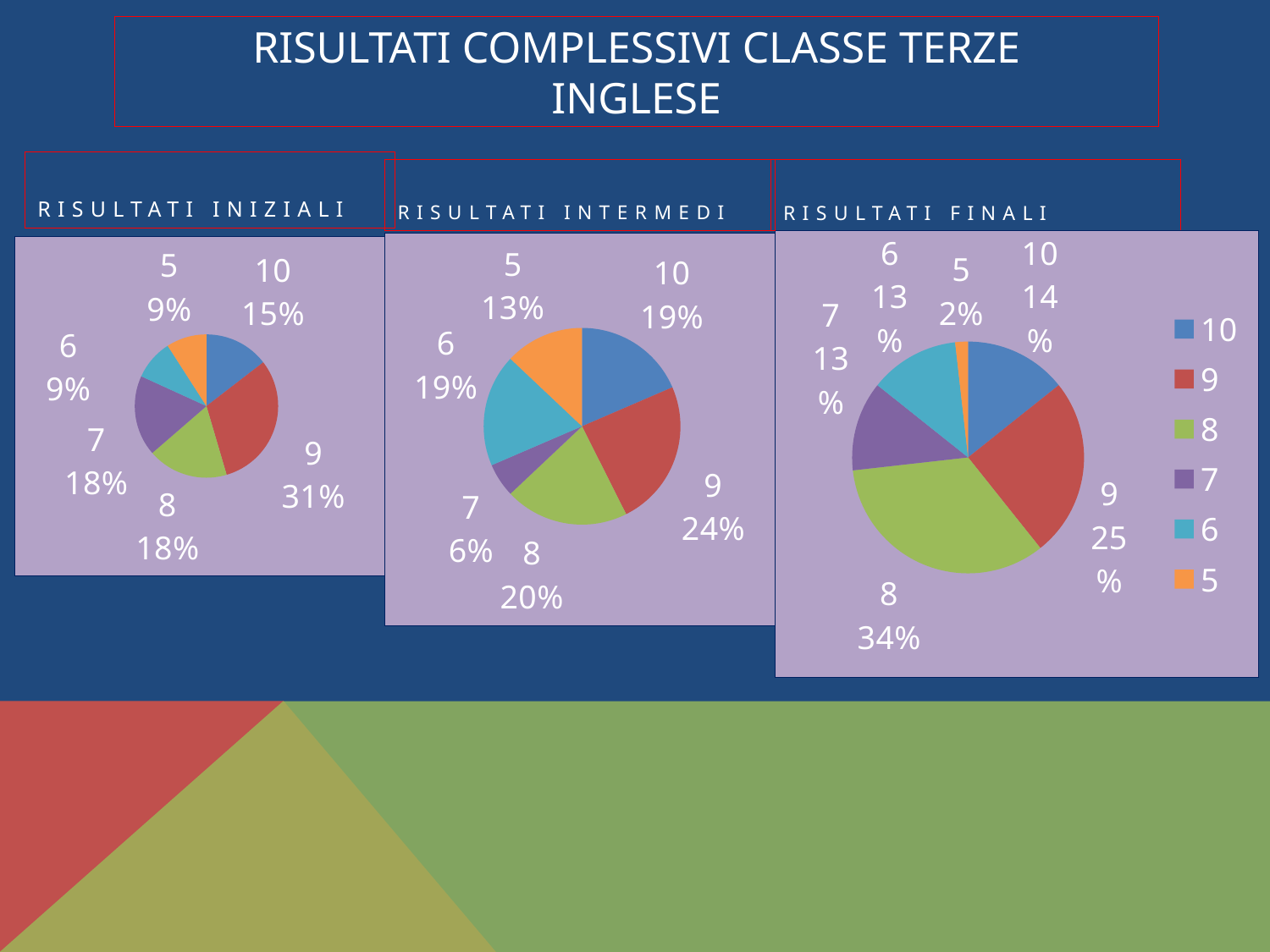
In the Risultati Finali chart, which is larger, the share of grade 9 or the share of grade 10? 9 In the Risultati Intermedi chart, what is the difference between the shares of grade 9 and grade 7? 18% In the Risultati Finali chart, which grade has the smallest slice? 5 In the Risultati Iniziali chart, which grade has the largest slice? 9 How many slices does the Risultati Iniziali chart have? 6 What kind of chart is the Risultati Intermedi chart? Pie chart In the Risultati Intermedi chart, what share does grade 7 have? 6% In the Risultati Iniziali chart, what share does grade 9 have? 31% How many entries does the legend of the Risultati Finali chart list? 6 In the Risultati Intermedi chart, which grade has the largest slice? 9 In the Risultati Finali chart, what colour is the slice for grade 8? Green In the Risultati Finali chart, what share does grade 8 have? 34%